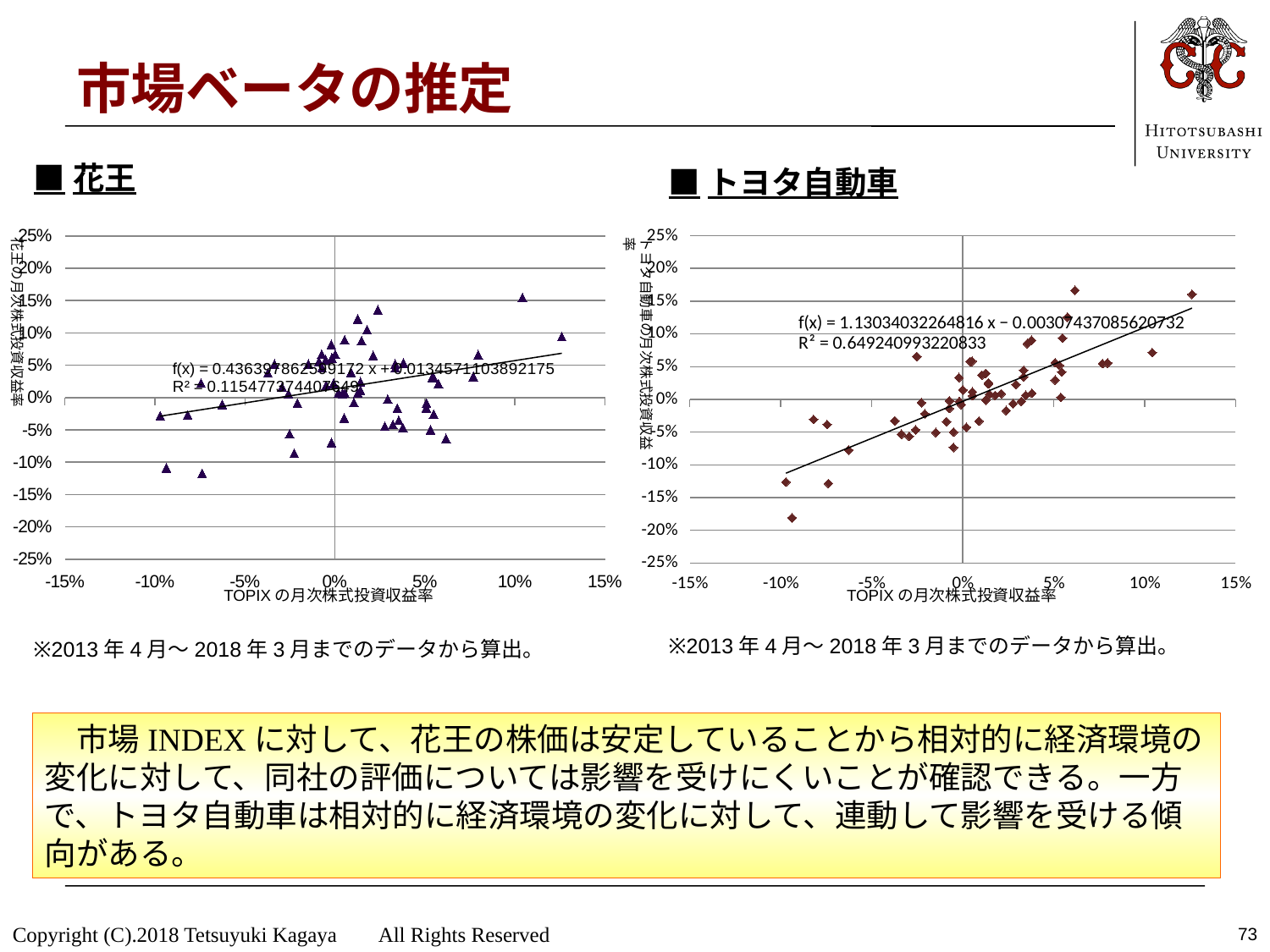
In the 花王 chart, what is the slope (coefficient of x) in the printed trendline equation? 0.436397862599172 What kind of chart is used for 花王 on the left of the slide? scatter chart How many charts are shown on the slide? 2 In the 花王 chart, is the lowest plotted point greater or less than -10%? less In the トヨタ自動車 chart, what is the intercept in the printed trendline equation? −0.00307437085620732 Which chart has the higher R² value, 花王 or トヨタ自動車? トヨタ自動車 In the トヨタ自動車 chart, what is the slope (coefficient of x) in the printed trendline equation? 1.13034032264816 In the トヨタ自動車 chart, do the points generally rise or fall as the TOPIX return increases along the x axis? rise In the トヨタ自動車 chart, is the lowest plotted point greater or less than -15%? less What is the x-axis label on both charts? TOPIX の月次株式投資収益率 In the トヨタ自動車 chart, what is the R² value printed for the trendline? 0.649240993220833 Which chart has the steeper trendline slope, 花王 or トヨタ自動車? トヨタ自動車